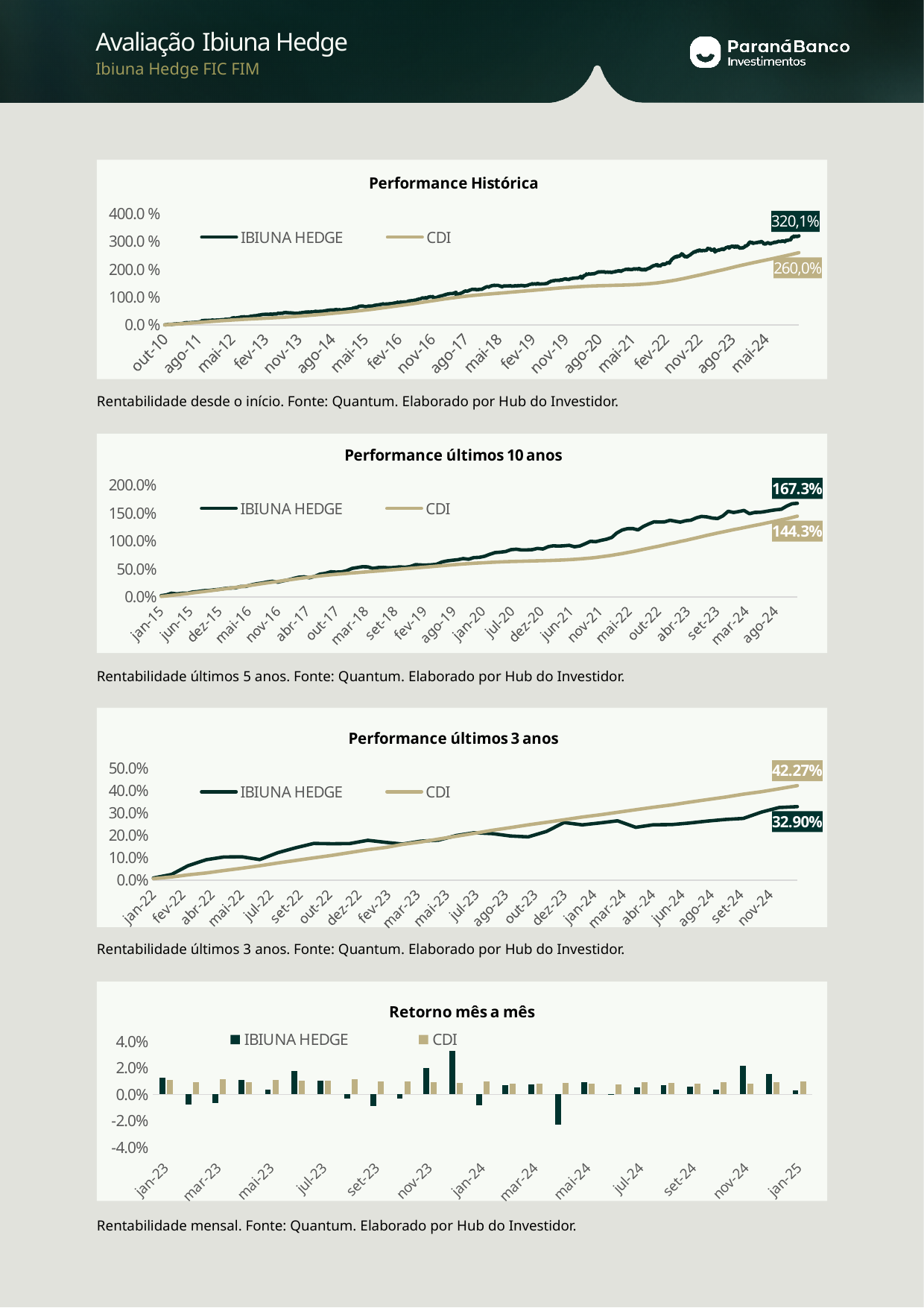
In the 'Performance últimos 3 anos' chart, what is the final value shown for CDI? 42.27% In the 'Performance Histórica' chart, which series ends higher, IBIUNA HEDGE or CDI? IBIUNA HEDGE In the 'Performance últimos 10 anos' chart, what is the final value shown for IBIUNA HEDGE? 167.3% In the 'Performance Histórica' chart, what is the final value shown for IBIUNA HEDGE? 320,1% How many series does the legend of the 'Retorno mês a mês' chart list? 2 In the 'Performance últimos 3 anos' chart, what is the difference between the final CDI value and the final IBIUNA HEDGE value? 9.37 percentage points In the 'Performance Histórica' chart, what is the final value shown for CDI? 260,0% In the 'Performance Histórica' chart, do the values generally rise or fall along the x axis? Rise What kind of chart is 'Retorno mês a mês'? Bar chart In the 'Performance últimos 10 anos' chart, what is the difference between the final IBIUNA HEDGE value and the final CDI value? 23.0 percentage points In the 'Performance últimos 3 anos' chart, which series ends higher, IBIUNA HEDGE or CDI? CDI